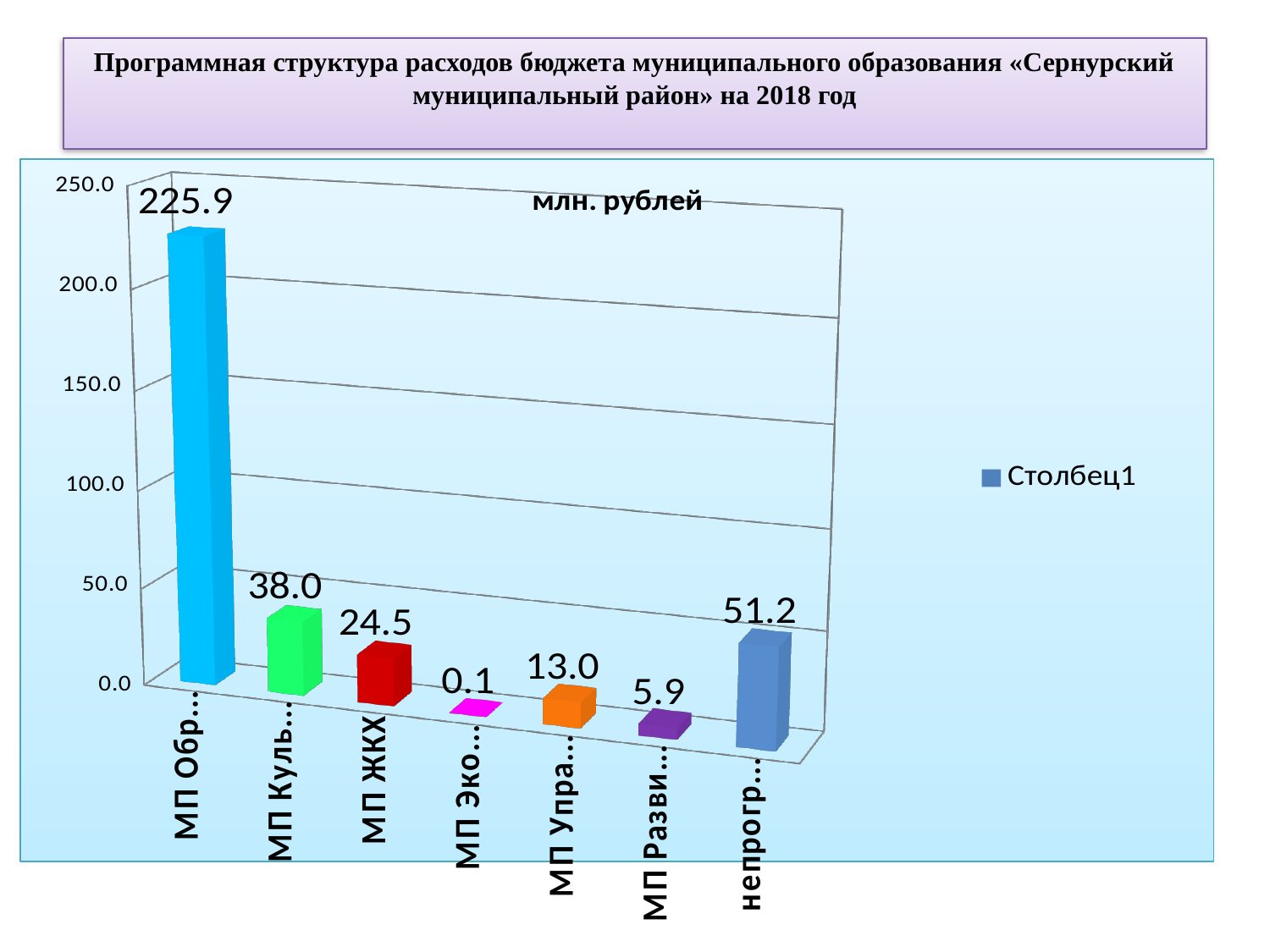
How many series does the legend list? 1 What type of chart is shown on the slide? bar chart What is the legend entry shown on the chart? Столбец1 What is the value of the last bar, labelled "непрогр..."? 51.2 Which is larger, the value for "непрогр..." or the value for "МП Куль..."? непрогр... What is the value of the first bar, labelled "МП Обр..."? 225.9 Which category has the lowest value? МП Эко... Which category has the highest value? МП Обр... How many bars (categories) does the chart show? 7 What is the value for the bar labelled "МП Упра..."? 13.0 What is the value for "МП ЖКХ"? 24.5 What is the difference between the values for "МП Куль..." and "МП ЖКХ"? 13.5